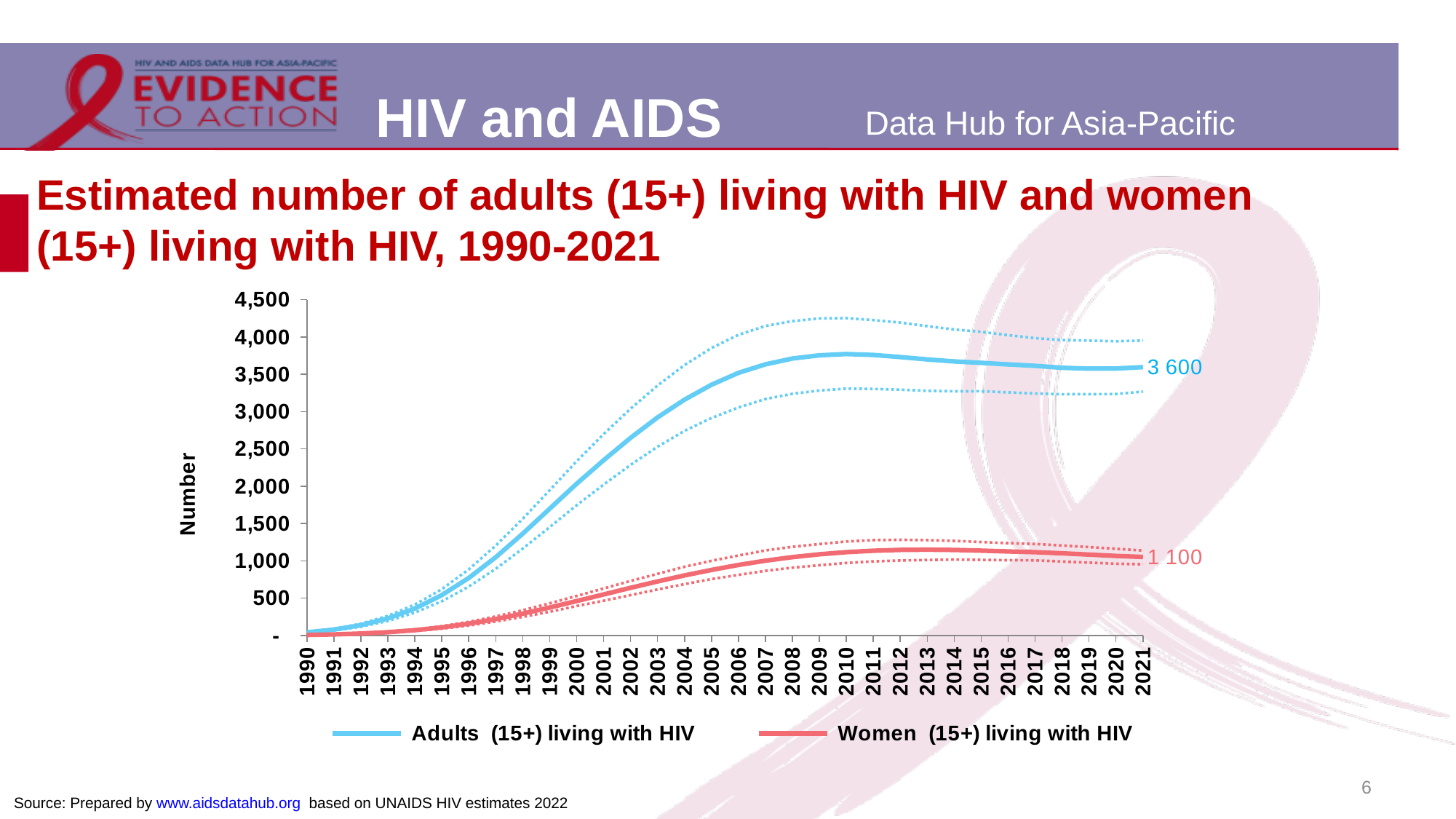
What kind of chart is shown on the slide? Line chart Is the value for Women (15+) living with HIV in 2010 greater or less than 1,500? less What is the difference between the 2021 values for adults (15+) living with HIV and women (15+) living with HIV? 2 500 In 2021, which series has the larger value: Adults (15+) living with HIV or Women (15+) living with HIV? Adults (15+) living with HIV Is the value for Adults (15+) living with HIV in 1995 greater or less than 1,000? less Is the value for Adults (15+) living with HIV in 2010 greater or less than 3,500? greater What is the title of the vertical axis of the chart? Number How many years are shown on the x axis of the chart? 32 Does the number of adults (15+) living with HIV rise or fall between 1990 and 2010? Rise How many series does the chart legend list? 2 What is the estimated number of women (15+) living with HIV in 2021? 1 100 What is the estimated number of adults (15+) living with HIV in 2021? 3 600